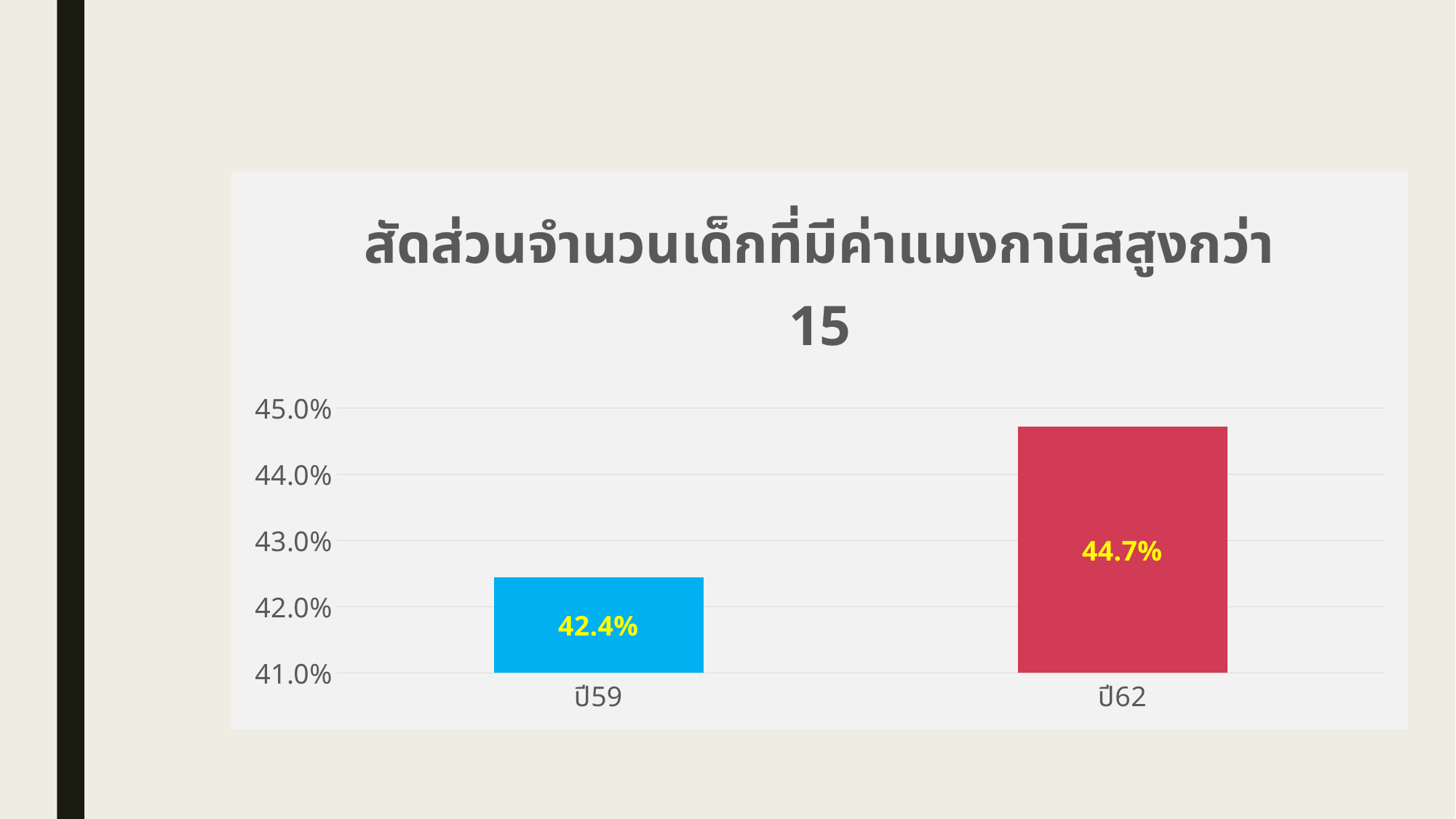
Which is larger, the value for ปี59 or the value for ปี62? ปี62 What is the value for ปี59? 42.4% How many categories are shown on the x axis? 2 Is the value for ปี59 greater or less than 43.0%? less Do the values rise or fall from ปี59 to ปี62? rise What is the difference between the values for ปี62 and ปี59? 2.3% Is the value for ปี62 greater or less than 44.0%? greater What is the value for ปี62? 44.7% What kind of chart is shown on the slide? bar chart Which category has the highest value? ปี62 What is the title of the chart? สัดส่วนจำนวนเด็กที่มีค่าแมงกานิสสูงกว่า 15 Which category has the lowest value? ปี59